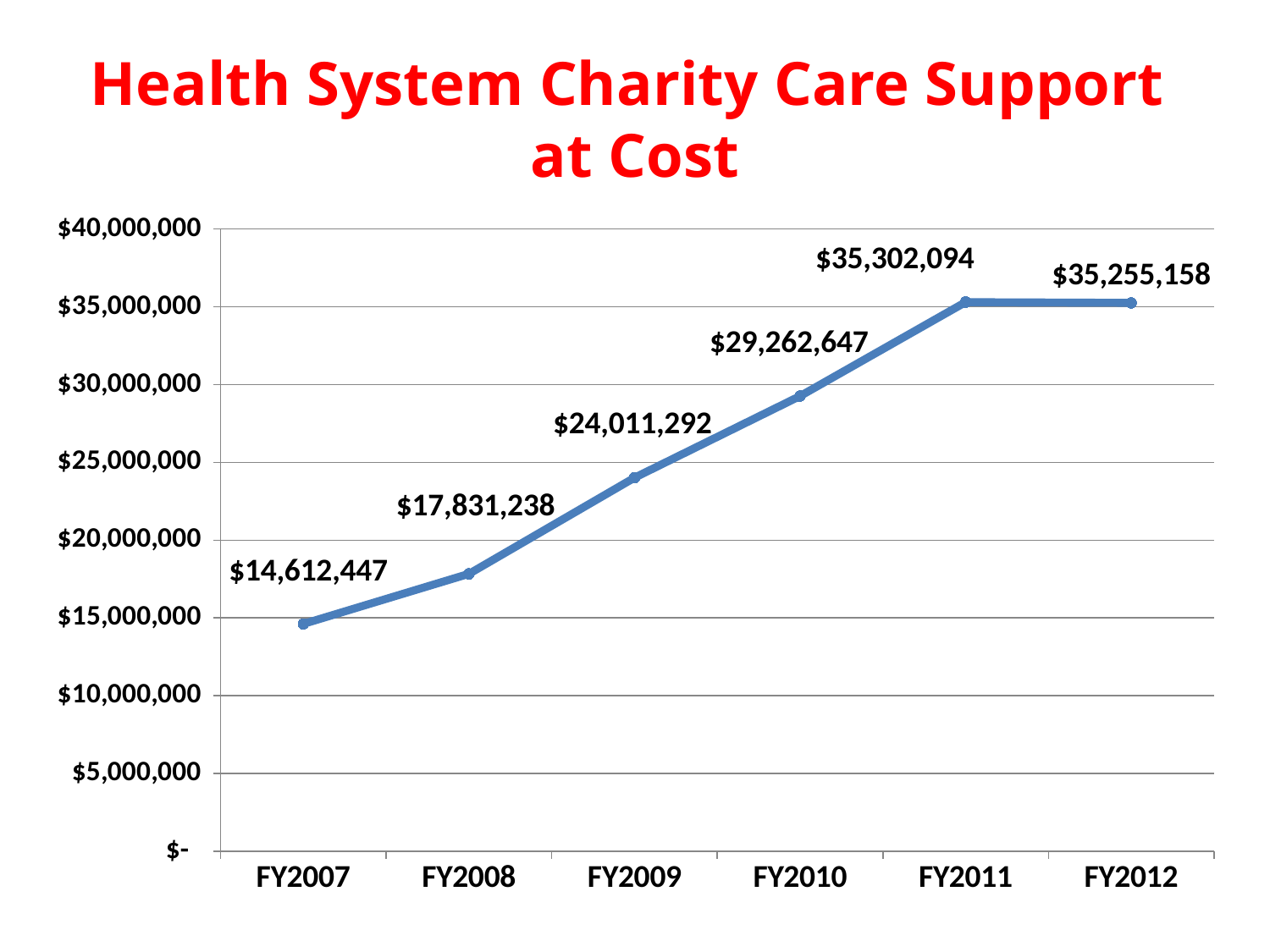
Is the value for FY2009 greater or less than $20,000,000? greater Which is larger, the value for FY2009 or the value for FY2008? FY2009 Which fiscal year has the lowest value? FY2007 What kind of chart is shown on the slide? line chart What is the value for FY2007? $14,612,447 What is the title of the chart? Health System Charity Care Support at Cost What is the difference between the FY2012 value and the FY2007 value? $20,642,711 What is the difference between the FY2011 value and the FY2010 value? $6,039,447 Which fiscal year has the highest value? FY2011 How many fiscal years are plotted on the chart? 6 What is the value for FY2012? $35,255,158 What is the value for FY2010? $29,262,647